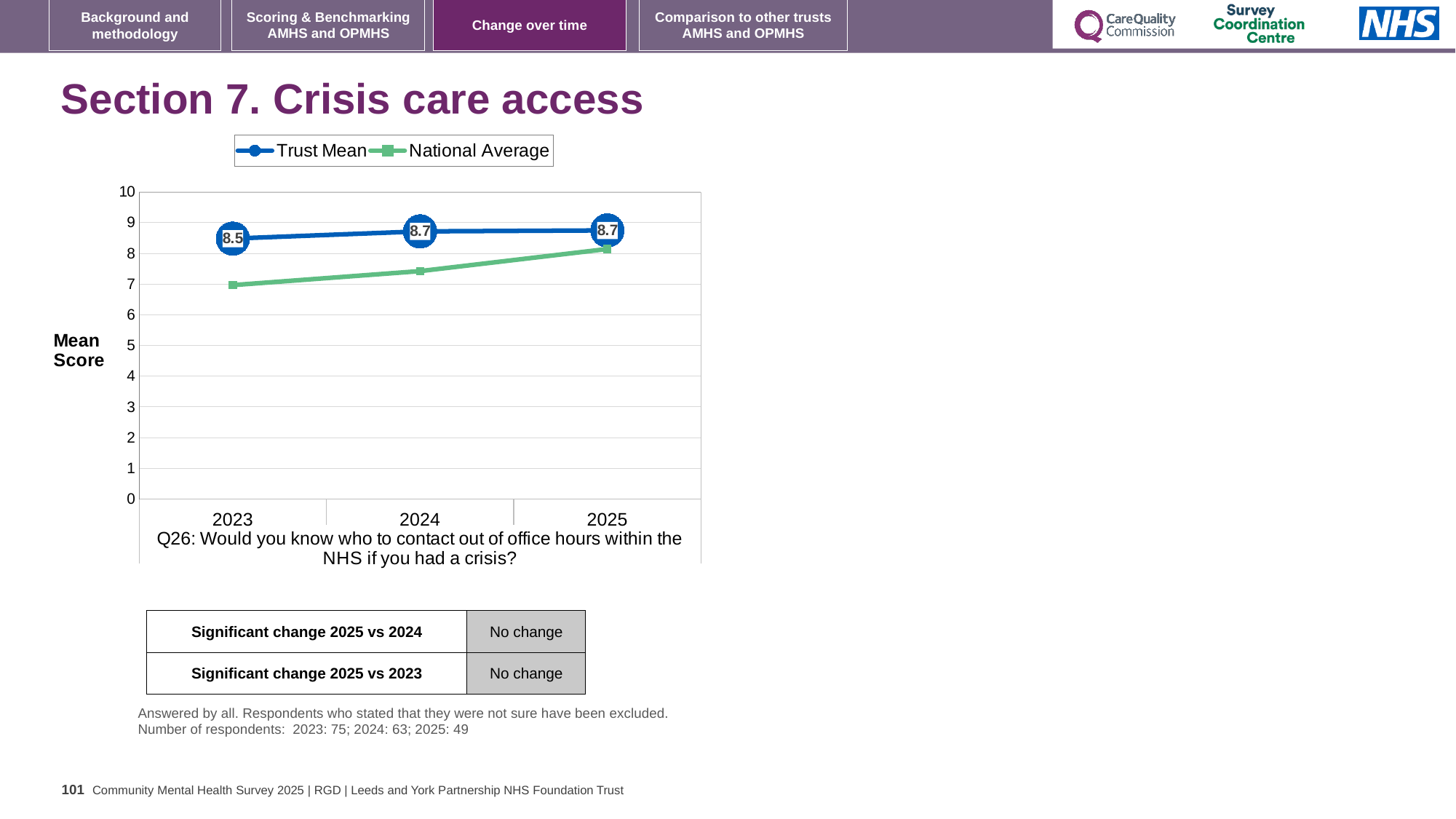
What is the Trust Mean value for 2024? 8.7 How many years are shown on the x axis of the chart? 3 What is the difference between the Trust Mean in 2024 and in 2023? 0.2 What kind of chart is shown on the slide? line chart How many series does the chart legend list? 2 In which year is the Trust Mean lowest? 2023 What is the Trust Mean value for 2025? 8.7 Is the National Average value for 2023 greater or less than 8? less What is the Trust Mean value for 2023? 8.5 In 2023, which is larger: the Trust Mean or the National Average? Trust Mean Does the National Average rise or fall from 2023 to 2025? rise Is the National Average value for 2025 greater or less than 7? greater